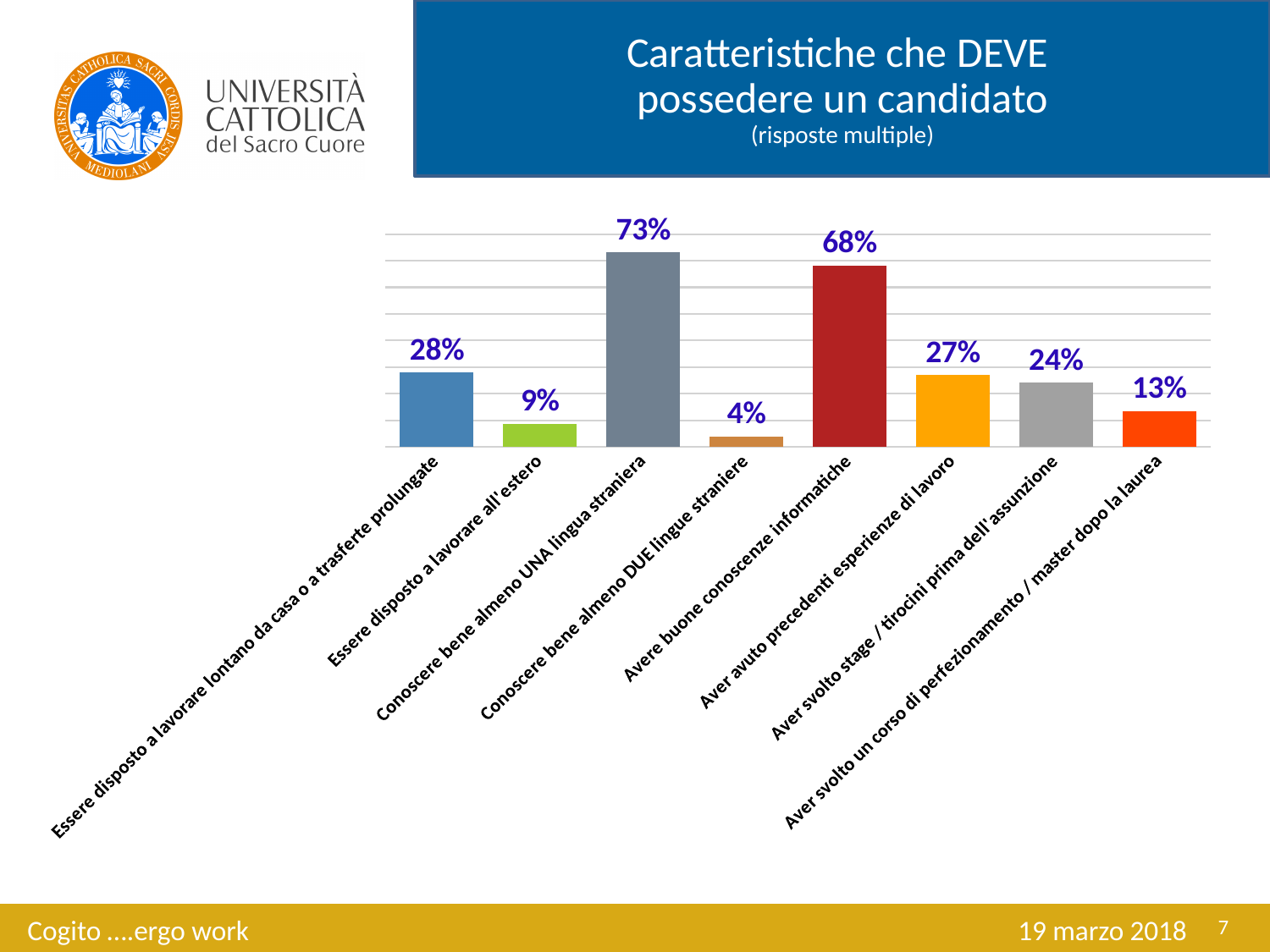
What is the value for "Aver svolto un corso di perfezionamento / master dopo la laurea"? 13% What is the value for "Essere disposto a lavorare all'estero"? 9% Which category has the lowest value? Conoscere bene almeno DUE lingue straniere Which is larger: the value for "Aver avuto precedenti esperienze di lavoro" or the value for "Aver svolto un corso di perfezionamento / master dopo la laurea"? Aver avuto precedenti esperienze di lavoro What kind of chart is shown on the slide? Bar chart What is the value for "Avere buone conoscenze informatiche"? 68% What is the value for "Conoscere bene almeno UNA lingua straniera"? 73% What is the title of the chart on the slide? Caratteristiche che DEVE possedere un candidato What is the difference between the values for "Essere disposto a lavorare lontano da casa o a trasferte prolungate" and "Aver svolto stage / tirocini prima dell'assunzione"? 4% What is the difference between the values for "Conoscere bene almeno UNA lingua straniera" and "Avere buone conoscenze informatiche"? 5% Which category has the highest value? Conoscere bene almeno UNA lingua straniera How many categories are shown in the chart? 8